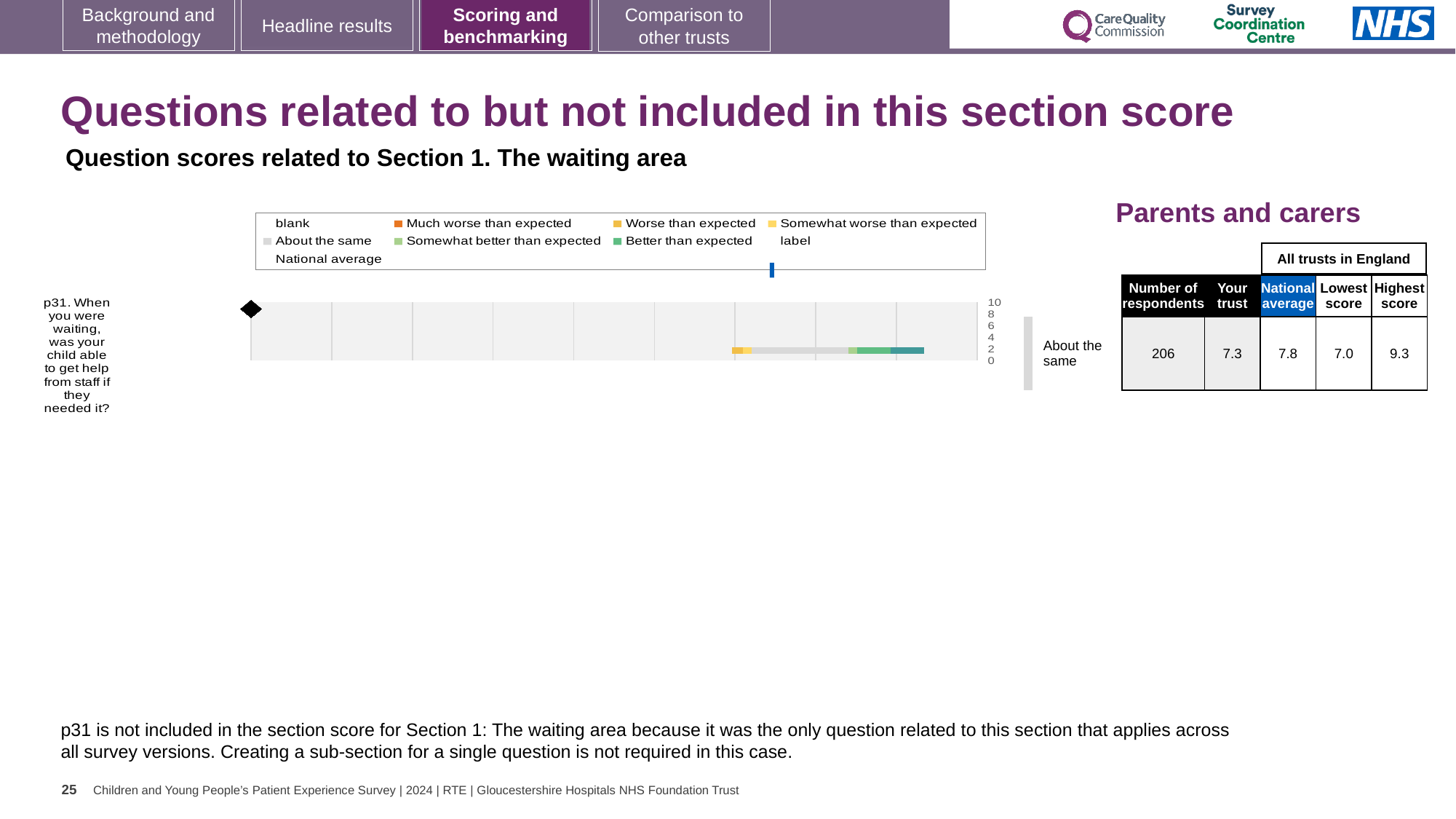
For p31, what is the difference between the highest score and the lowest score among all trusts in England? 2.3 Which question number is plotted in the chart? p31 How many questions are plotted in the chart? 1 In the Parents and carers table, what is the national average score for p31? 7.8 What kind of chart is used to show the p31 result? bar chart For p31, which is larger: the 'Your trust' score or the national average? National average In the Parents and carers table, what is the lowest score among all trusts in England for p31? 7.0 In the Parents and carers table, what is the number of respondents for p31? 206 Which benchmarking category is the trust's result for p31 labelled as? About the same What colour does the legend use for 'Much worse than expected'? Orange In the Parents and carers table, what is the highest score among all trusts in England for p31? 9.3 In the Parents and carers table, what is the 'Your trust' score for p31? 7.3